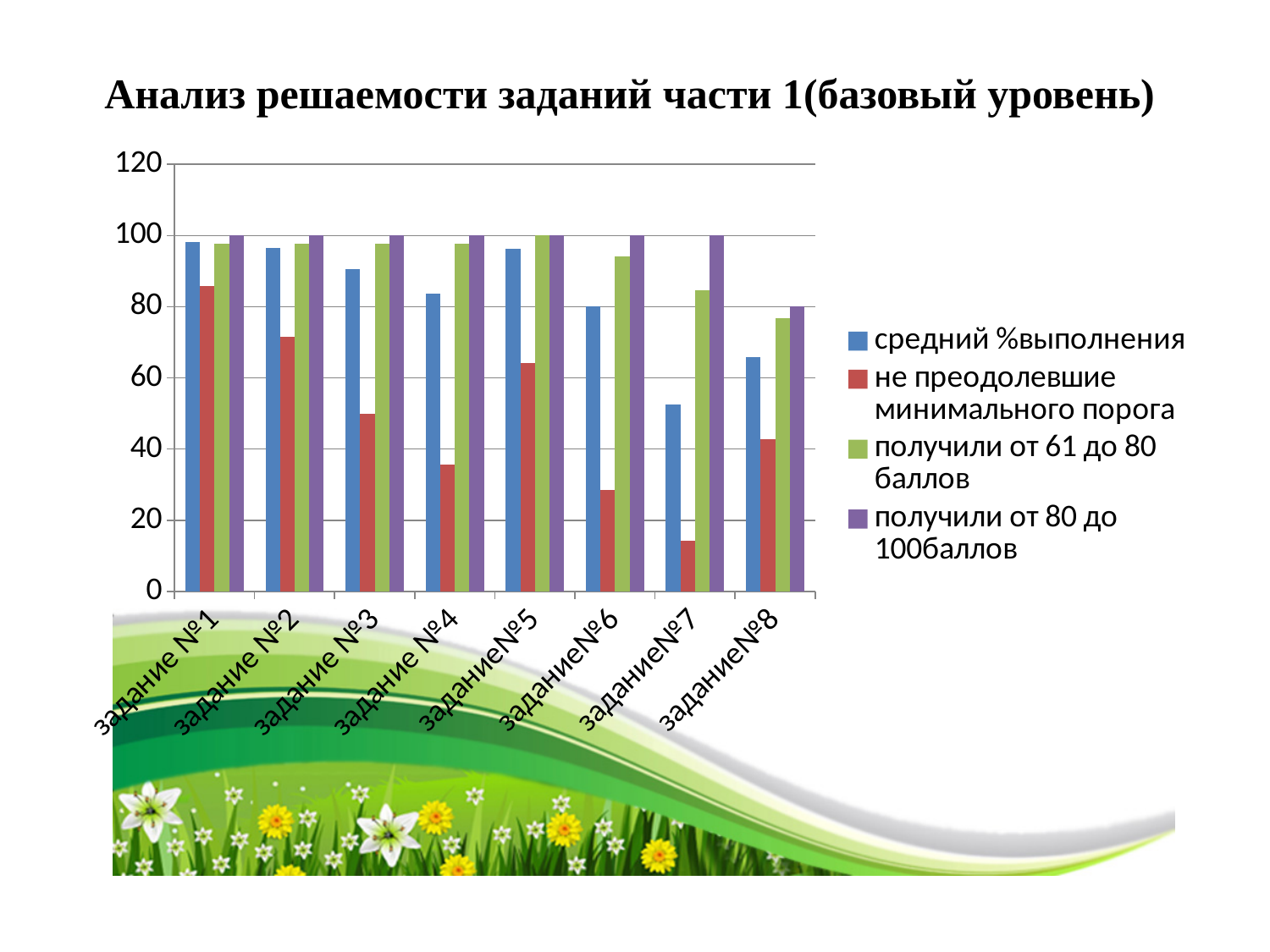
Is the value of 'не преодолевшие минимального порога' for задание №1 greater or less than 80? greater For which task is the 'не преодолевшие минимального порога' value the lowest? задание№7 For which task is the 'получили от 61 до 80 баллов' value the lowest? задание№8 How many series does the legend list? 4 Which series is shown in red? не преодолевшие минимального порога Which is larger for задание№6: 'средний %выполнения' or 'не преодолевшие минимального порога'? средний %выполнения Is the value of 'не преодолевшие минимального порога' for задание№7 greater or less than 20? less Is the value of 'средний %выполнения' for задание№8 greater or less than 60? greater What kind of chart is shown on the slide? bar chart What is the title of the slide? Анализ решаемости заданий части 1(базовый уровень) How many tasks (categories) are shown on the x axis? 8 What is the value of 'получили от 80 до 100баллов' for задание №1? 100